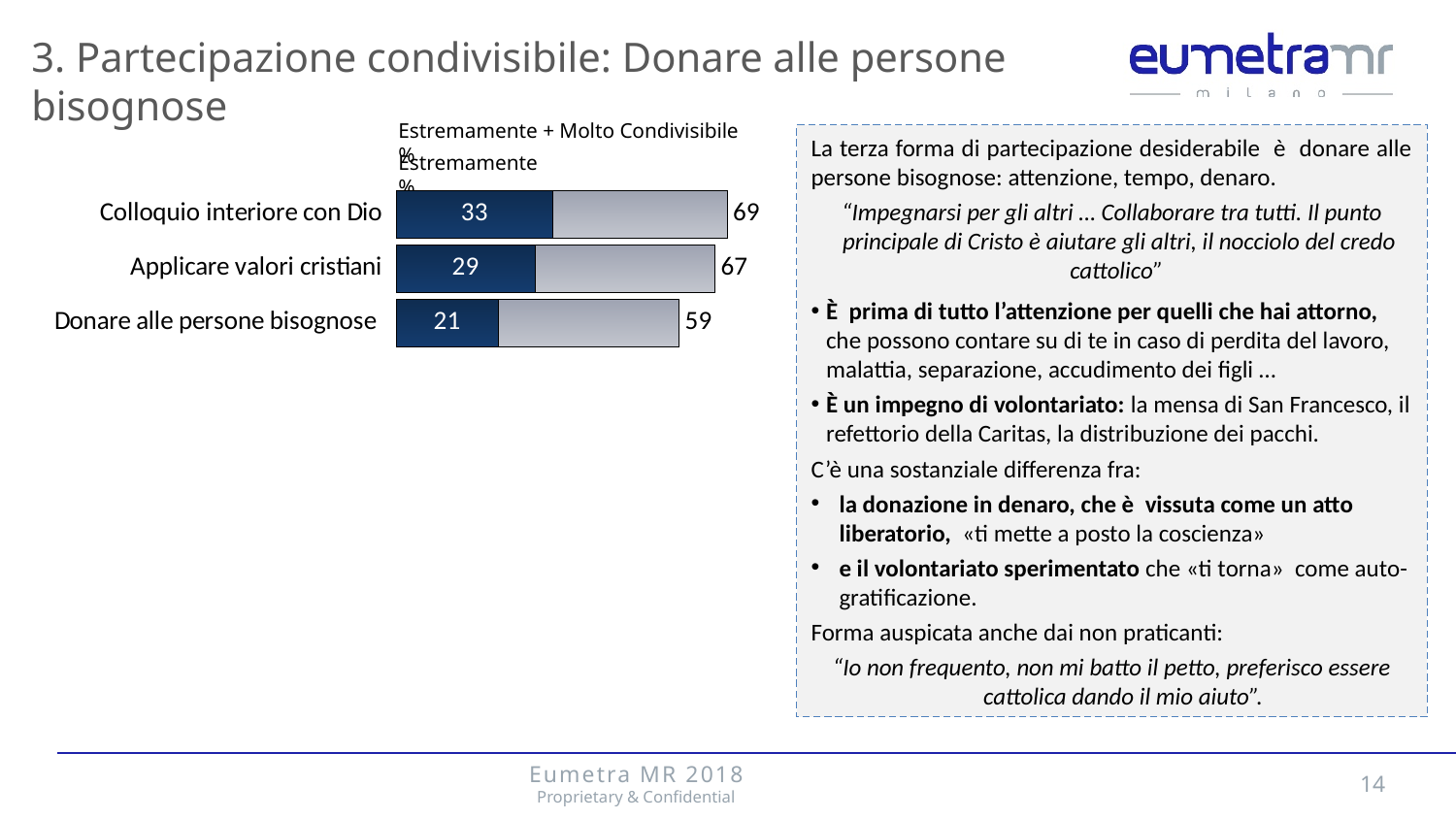
Which category has the highest 'Estremamente + Molto Condivisibile' value? Colloquio interiore con Dio What is the 'Estremamente + Molto Condivisibile' value for Applicare valori cristiani? 67 How many categories are shown in the chart? 3 What is the difference between the 'Estremamente + Molto Condivisibile' values for Colloquio interiore con Dio and Donare alle persone bisognose? 10 What is the 'Estremamente + Molto Condivisibile' value for Donare alle persone bisognose? 59 What is the 'Estremamente' value for Applicare valori cristiani? 29 What is the 'Estremamente' value for Colloquio interiore con Dio? 33 How many series does the chart legend list? 2 What is the difference between the 'Estremamente' values for Colloquio interiore con Dio and Donare alle persone bisognose? 12 What kind of chart is shown on the slide? Bar chart Which is larger: the 'Estremamente' value for Applicare valori cristiani or for Donare alle persone bisognose? Applicare valori cristiani Which category has the lowest 'Estremamente' value? Donare alle persone bisognose